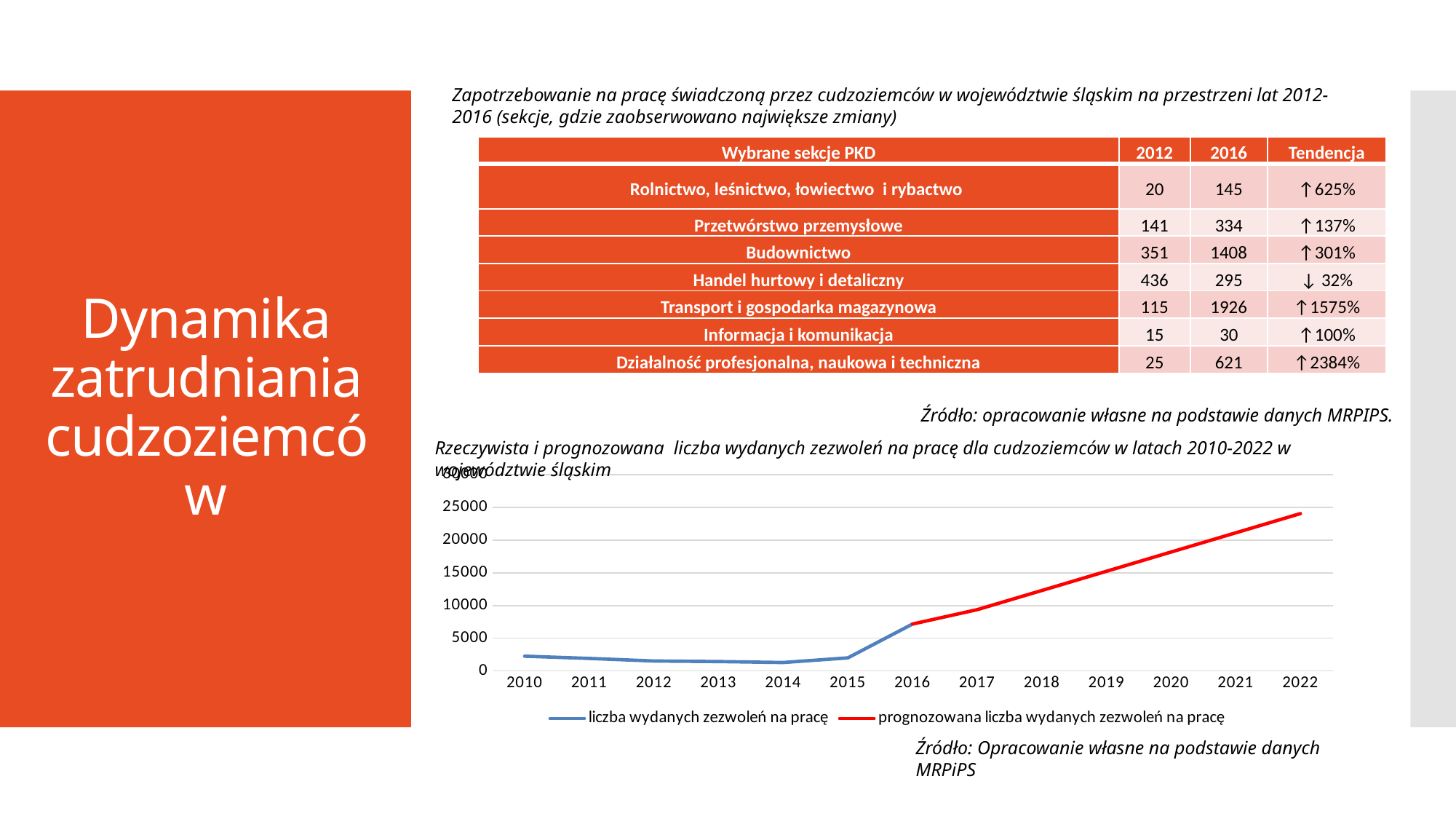
In the line chart, is the value for 2020 greater or less than 15000? greater In the line chart, do the values rise or fall from 2016 to 2022? rise In the line chart, which series is drawn in blue? liczba wydanych zezwoleń na pracę How many years are marked on the x axis of the line chart? 13 In the line chart, is the value for 2010 greater or less than 5000? less What kind of chart is shown at the bottom of the slide? line chart How many series does the legend of the line chart list? 2 In the line chart, which series is drawn in red? prognozowana liczba wydanych zezwoleń na pracę In the line chart, is the value for 2019 greater or less than 10000? greater